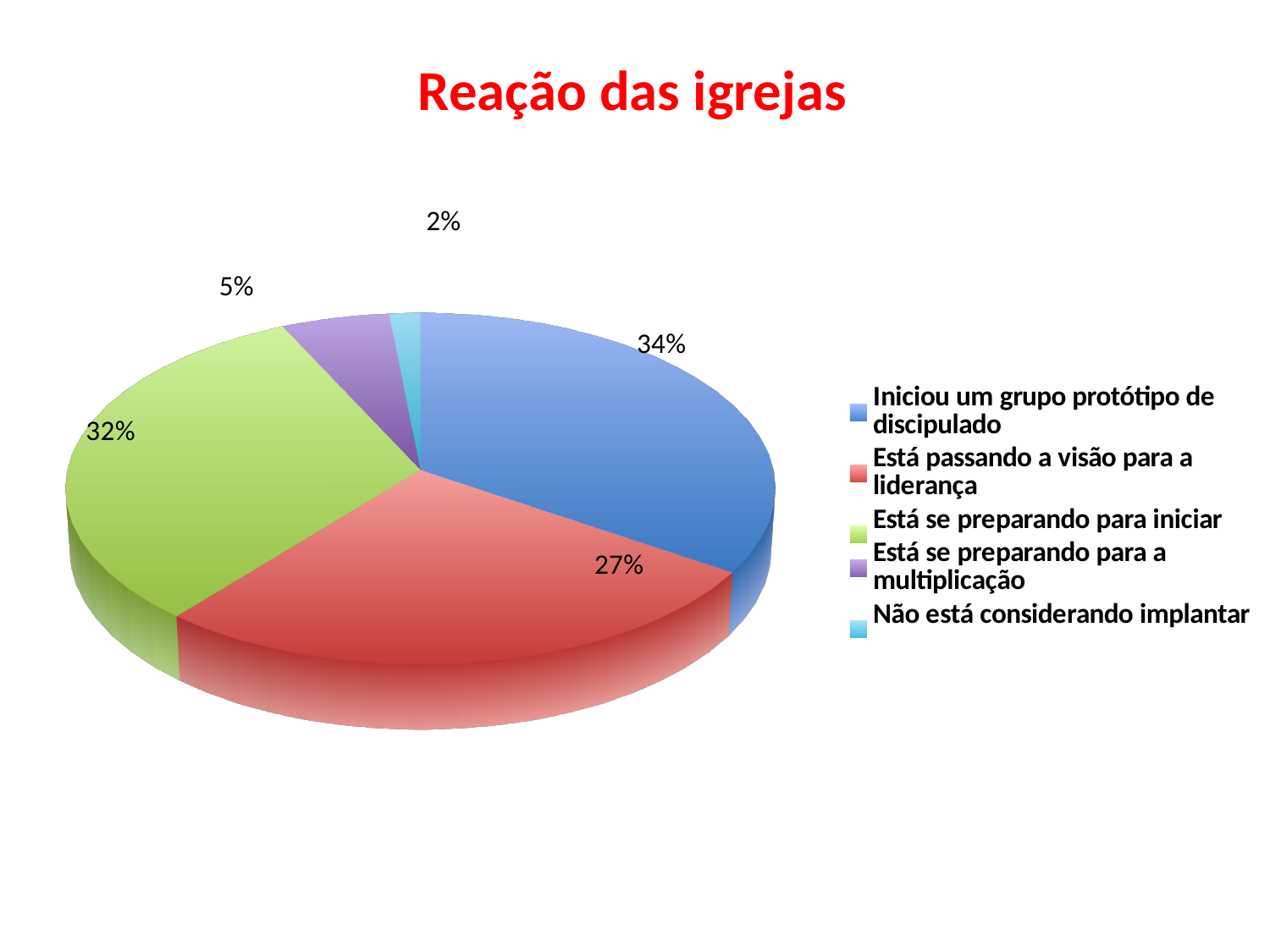
What share of the pie is 'Está se preparando para iniciar'? 32% What share of the pie is 'Iniciou um grupo protótipo de discipulado'? 34% Which category has the largest share of the pie? Iniciou um grupo protótipo de discipulado Which category has the smallest share of the pie? Não está considerando implantar How many categories does the pie chart have? 5 What share of the pie is 'Não está considerando implantar'? 2% What is the difference in percentage points between 'Está se preparando para iniciar' and 'Está passando a visão para a liderança'? 5 percentage points What is the title of the chart? Reação das igrejas Which is larger: the share for 'Está se preparando para a multiplicação' or the share for 'Não está considerando implantar'? Está se preparando para a multiplicação What kind of chart is shown on the slide? Pie chart